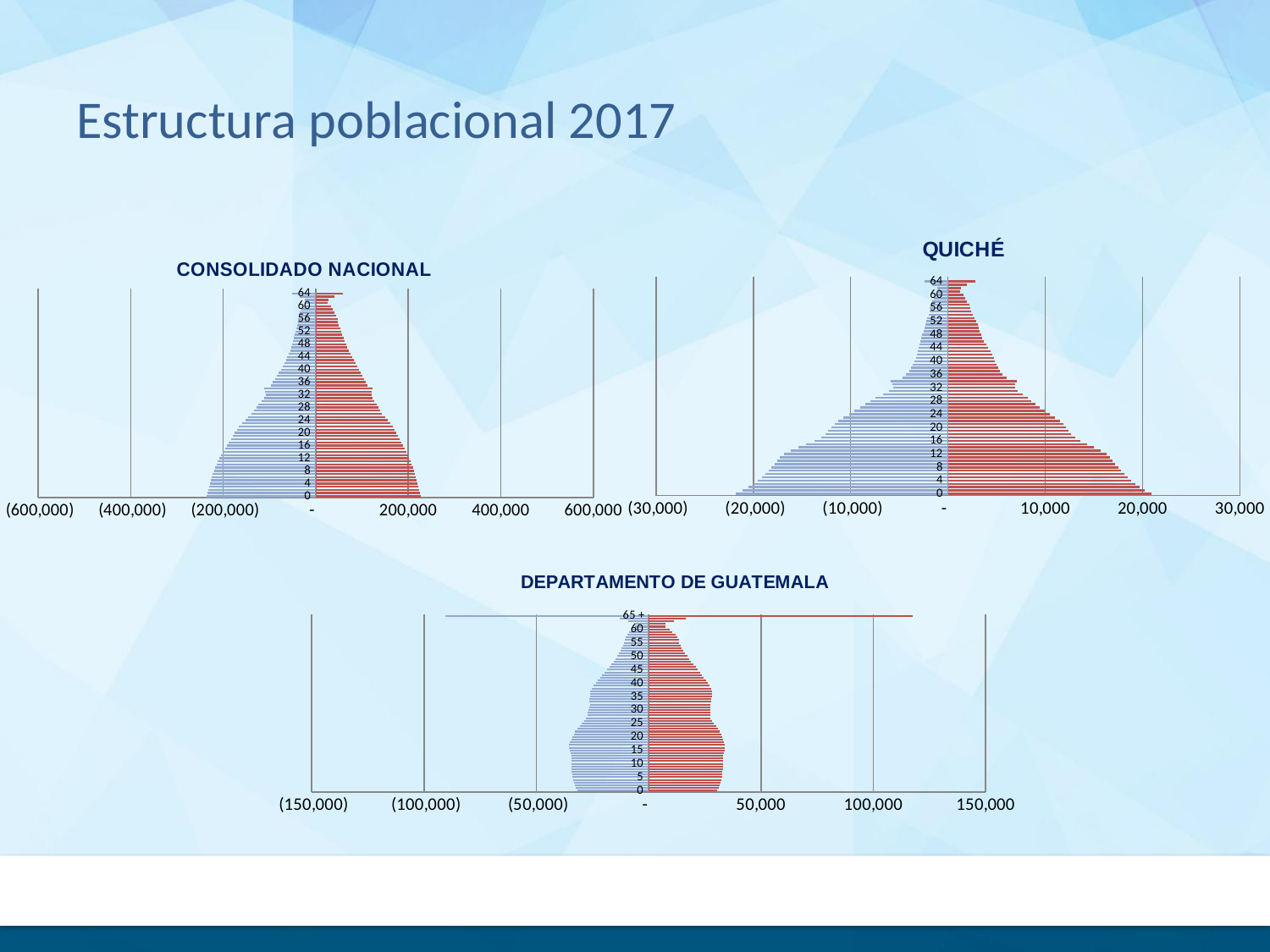
How many charts are shown on the slide? 3 What is the title of the chart at the bottom of the slide? DEPARTAMENTO DE GUATEMALA In the CONSOLIDADO NACIONAL chart, is the red bar for age 0 greater or less than 400,000? less In the QUICHÉ chart, do the red bars generally get longer or shorter as age increases from 0 to 64? shorter In the QUICHÉ chart, what is the highest value shown on the x axis? 30,000 In the QUICHÉ chart, is the red bar for age 0 greater or less than 10,000? greater In the DEPARTAMENTO DE GUATEMALA chart, is the red bar for the 65+ group greater or less than 100,000? greater What kind of chart is the CONSOLIDADO NACIONAL chart? bar chart In the DEPARTAMENTO DE GUATEMALA chart, what is the highest value shown on the x axis? 150,000 In the QUICHÉ chart, which is longer: the red bar for age 0 or the red bar for age 60? age 0 What is the title of the chart at the top right of the slide? QUICHÉ In the CONSOLIDADO NACIONAL chart, what is the highest value shown on the x axis? 600,000